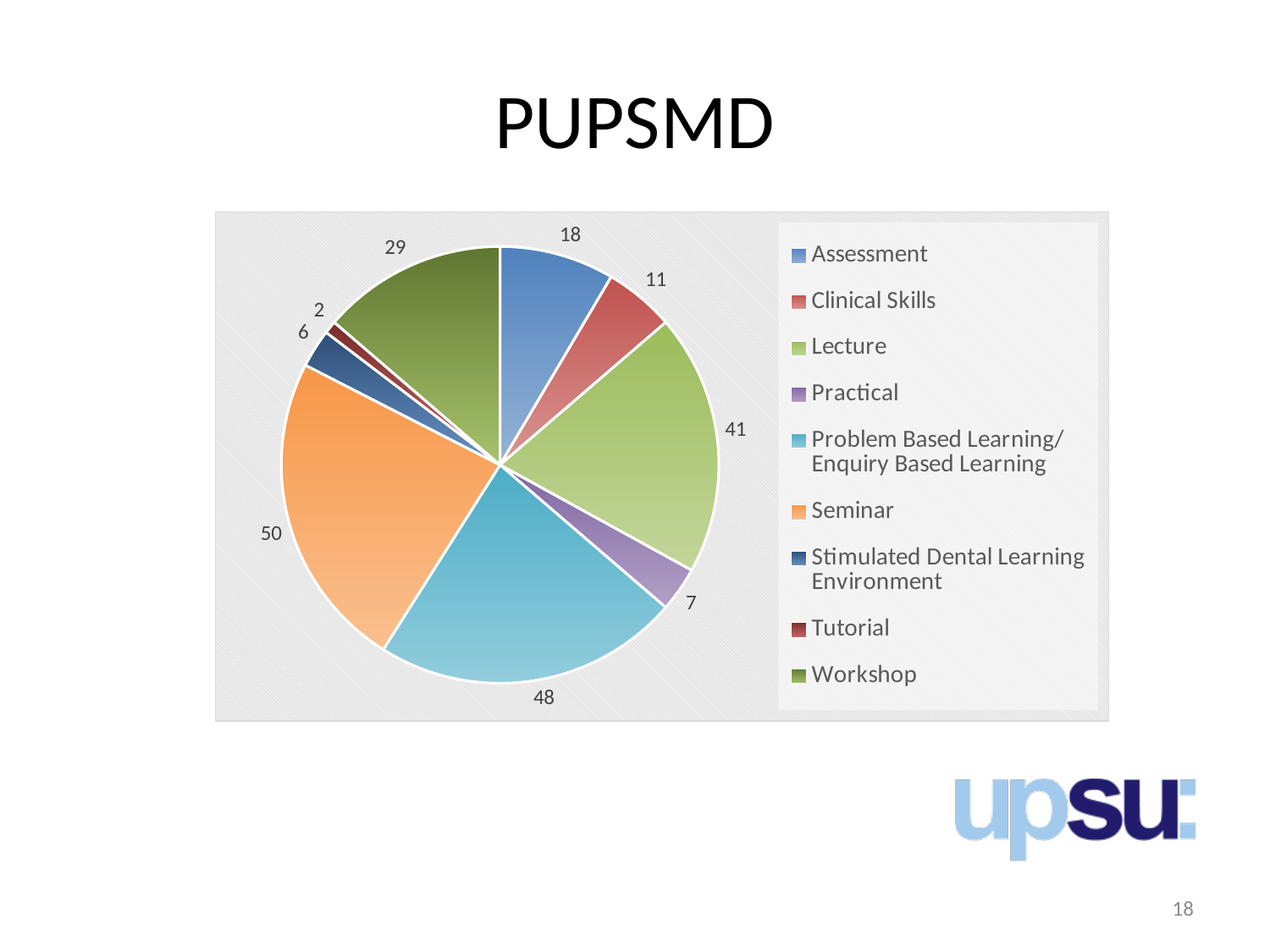
What is the title of the slide containing the chart? PUPSMD What is the difference between the values for Seminar and Problem Based Learning/Enquiry Based Learning? 2 What is the value for Lecture? 41 Which category has the largest slice? Seminar What is the value for Tutorial? 2 Which category has the smallest slice? Tutorial What is the value for Problem Based Learning/Enquiry Based Learning? 48 What is the difference between the values for Workshop and Assessment? 11 Which is larger, the value for Lecture or the value for Workshop? Lecture How many categories does the pie chart have? 9 What is the value for Seminar? 50 What type of chart is shown on the slide? Pie chart